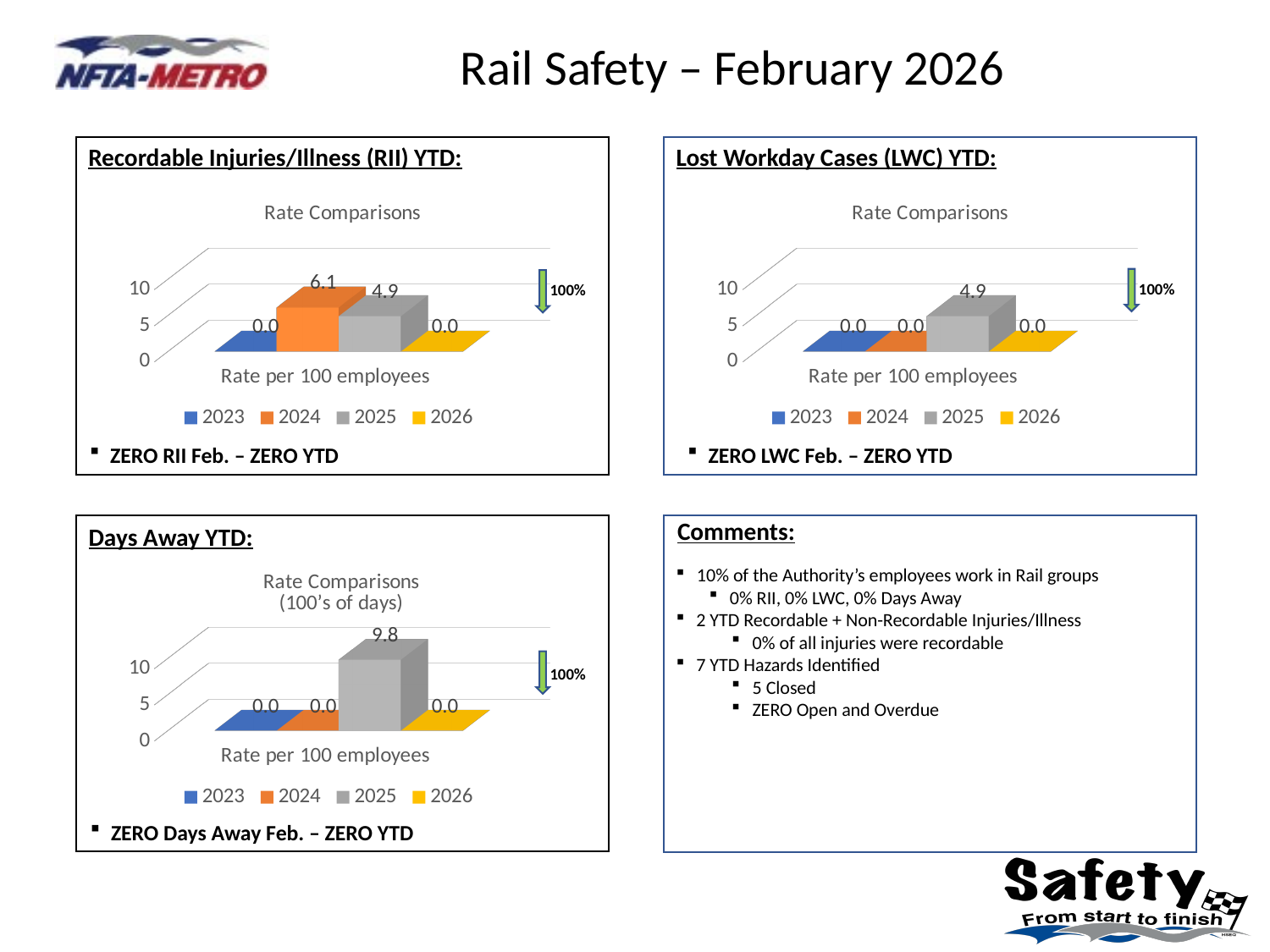
In the Lost Workday Cases (LWC) YTD chart, what is the value for 2026? 0.0 In the Lost Workday Cases (LWC) YTD chart, what is the value for 2025? 4.9 How many series does the legend of the Days Away YTD chart list? 4 In the Days Away YTD chart, is the value for 2025 greater or less than 5? greater In the Recordable Injuries/Illness (RII) YTD chart, what is the value for 2025? 4.9 In the Recordable Injuries/Illness (RII) YTD chart, which year has the highest value? 2024 In the Recordable Injuries/Illness (RII) YTD chart, what is the difference between the 2024 and 2025 values? 1.2 In the Days Away YTD chart, which is larger, the value for 2024 or the value for 2025? 2025 In the Lost Workday Cases (LWC) YTD chart, which year has the highest value? 2025 What kind of chart is the Recordable Injuries/Illness (RII) YTD chart? Bar chart In the Days Away YTD chart, what is the value for 2025? 9.8 In the Recordable Injuries/Illness (RII) YTD chart, what is the value for 2024? 6.1